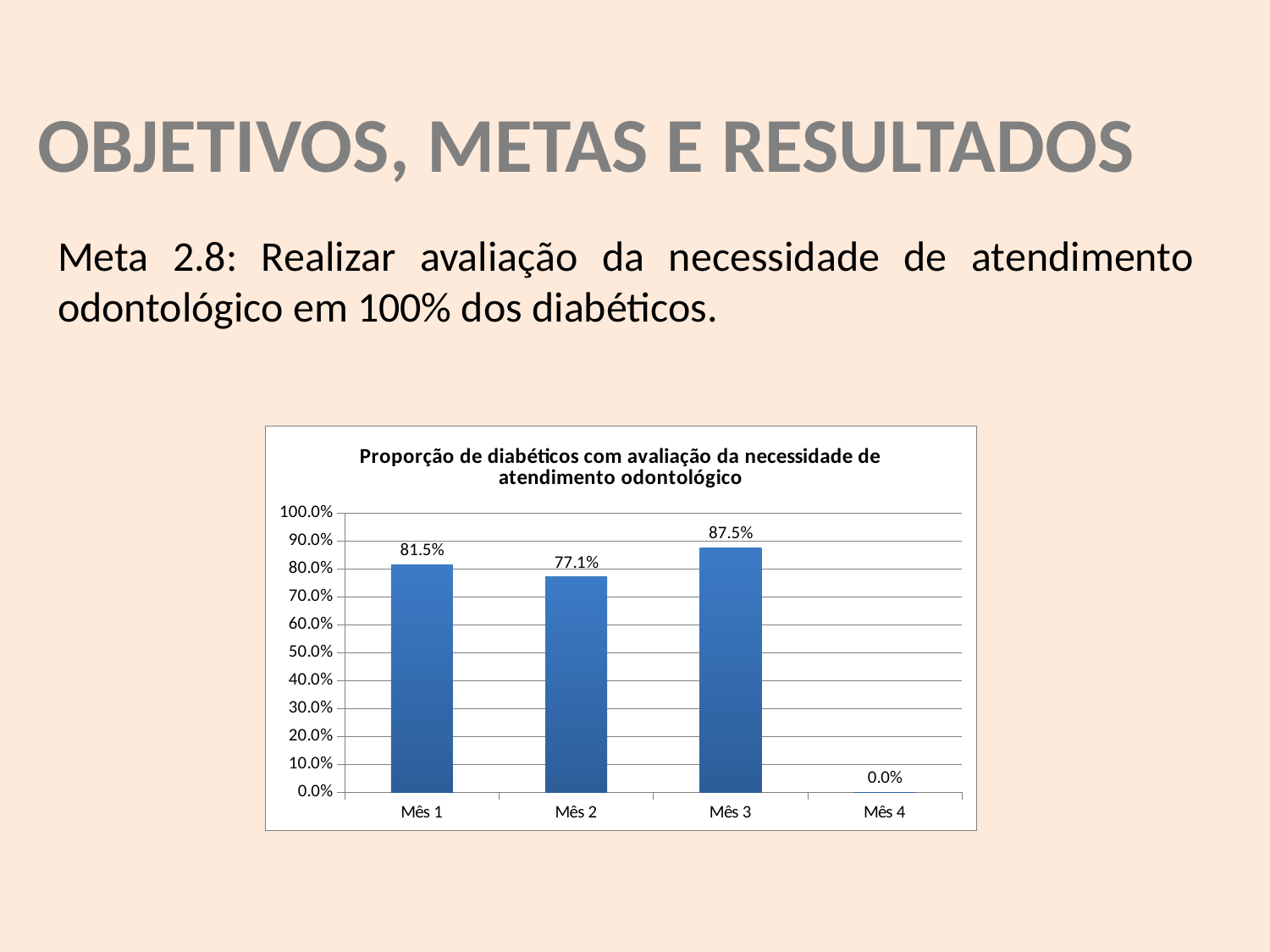
What is the difference between the values for Mês 3 and Mês 2? 10.4% What is the value for Mês 2? 77.1% What is the value for Mês 1? 81.5% Is the value for Mês 3 greater or less than 80.0%? greater Which month has the lowest value? Mês 4 What is the value for Mês 4? 0.0% What kind of chart is shown on the slide? Bar chart What is the value for Mês 3? 87.5% Which month has the highest value? Mês 3 Which is larger, the value for Mês 1 or the value for Mês 2? Mês 1 How many months are shown on the x axis? 4 What is the title of the chart? Proporção de diabéticos com avaliação da necessidade de atendimento odontológico